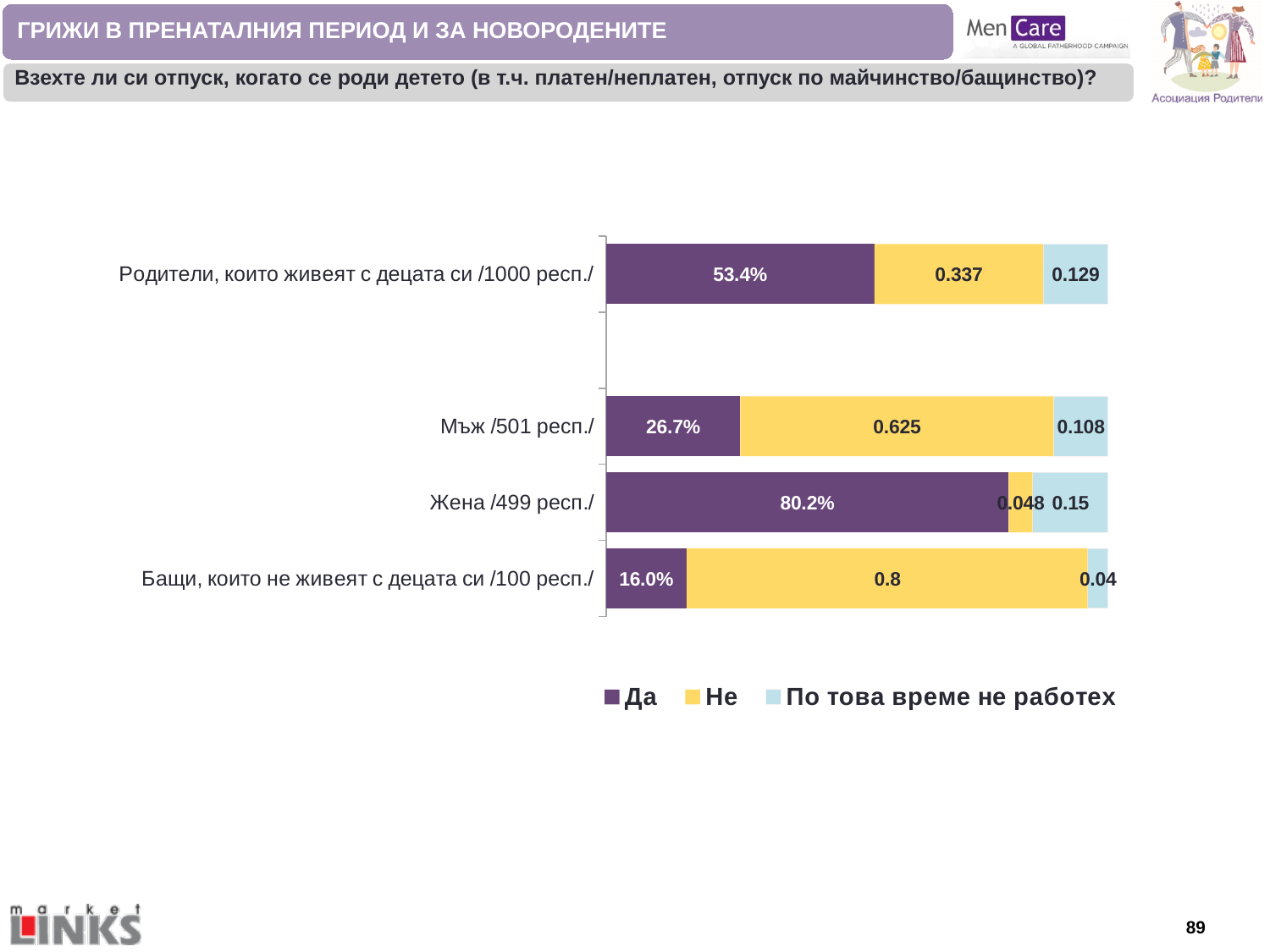
What kind of chart is shown on the slide? stacked bar chart What is the value of "По това време не работех" for "Жена /499 респ./"? 0.15 Which category has the lowest value for "По това време не работех"? Бащи, които не живеят с децата си /100 респ./ What is the value of "Не" for "Жена /499 респ./"? 0.048 What is the name of the series shown in yellow? Не How many categories are plotted in the chart? 4 Which is larger, the "Да" value for "Мъж /501 респ./" or for "Жена /499 респ./"? Жена /499 респ./ How many series does the legend list? 3 Which category has the highest value for "Да"? Жена /499 респ./ What is the value of "Не" for "Мъж /501 респ./"? 0.625 What is the value of "Да" for "Родители, които живеят с децата си /1000 респ./"? 53.4% What is the value of "Да" for "Бащи, които не живеят с децата си /100 респ./"? 16.0%